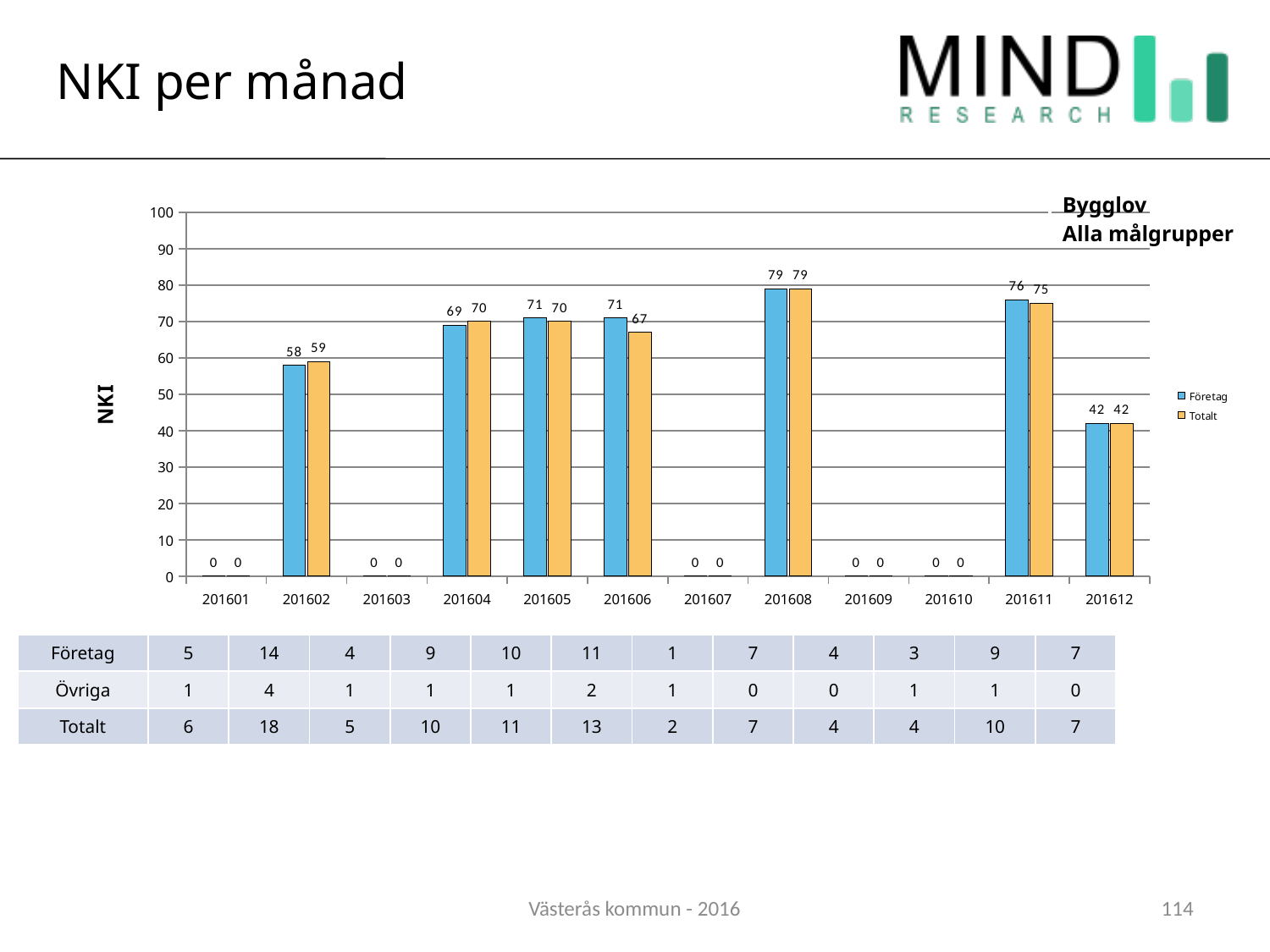
What kind of chart is shown? bar chart What is the Totalt value for 201606? 67 What is the label on the y axis? NKI How many series does the legend list? 2 Among the months with non-zero values, which month has the lowest Totalt value? 201612 What is the difference between the Företag values for 201611 and 201612? 34 What is the Företag value for 201608? 79 Which is larger, the Totalt value for 201604 or the Totalt value for 201605? Neither; both are 70 What is the difference between the Företag and Totalt values for 201606? 4 Which month has the highest Företag value? 201608 How many months are shown on the x axis? 12 What is the Totalt value for 201602? 59